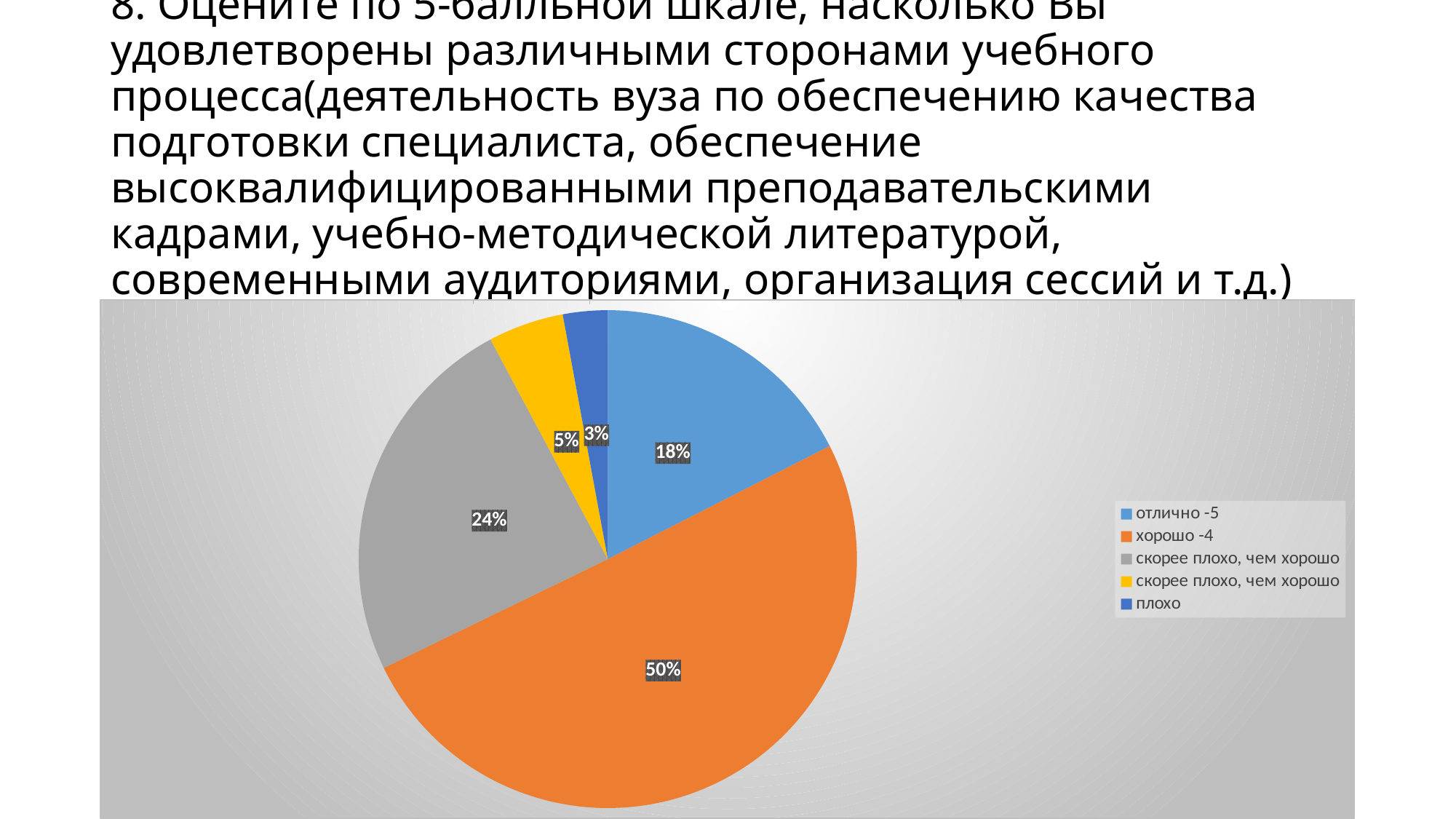
What share of the pie does the yellow slice take? 5% How many slices does the pie chart have? 5 Which is larger, the share for "отлично -5" or the share for "плохо"? отлично -5 How many entries does the legend list? 5 Which category has the smallest slice of the pie? плохо What kind of chart is shown on the slide? pie chart Which category has the largest slice of the pie? хорошо -4 What is the difference between the shares for "хорошо -4" and "отлично -5"? 32% What share of the pie does "отлично -5" take? 18% What share of the pie does "хорошо -4" take? 50%